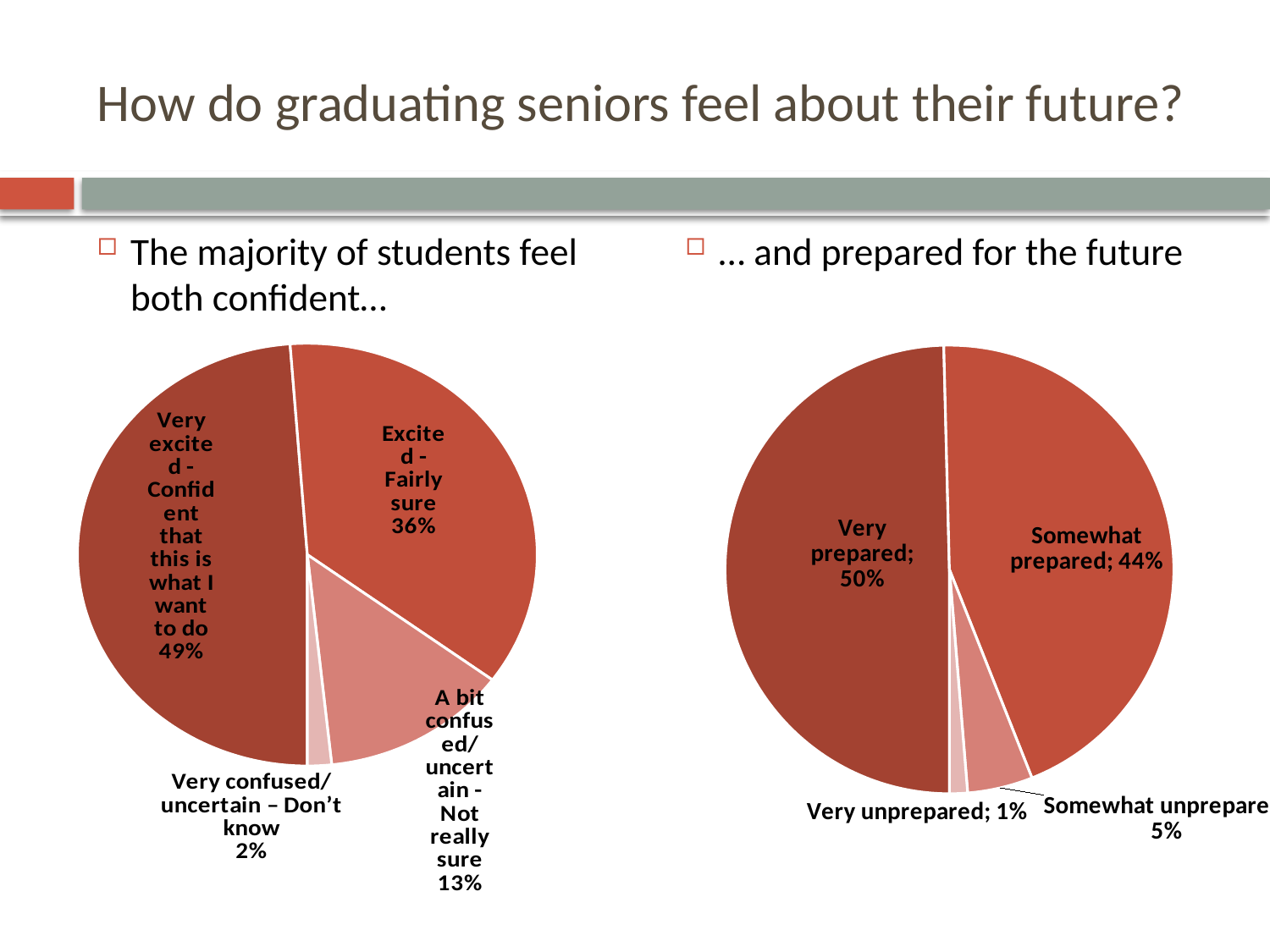
In the left pie chart, which category has the smallest share? Very confused/uncertain – Don't know In the left pie chart, what is the difference in percentage points between 'Excited - Fairly sure' and 'A bit confused/uncertain - Not really sure'? 23 How many slices does the left pie chart have? 4 In the left pie chart, what share of students are 'Very excited - Confident that this is what I want to do'? 49% In the left pie chart, which category has the largest share? Very excited - Confident that this is what I want to do In the right pie chart, which is larger: 'Somewhat unprepared' or 'Very unprepared'? Somewhat unprepared In the right pie chart, which category has the largest share? Very prepared In the right pie chart, what percentage of students are 'Very unprepared'? 1% What type of chart is shown on the right side of the slide? Pie chart In the right pie chart, what percentage of students are 'Somewhat prepared'? 44% In the left pie chart, what percentage of students are 'A bit confused/uncertain - Not really sure'? 13% In the right pie chart, what is the difference in percentage points between 'Very prepared' and 'Somewhat prepared'? 6